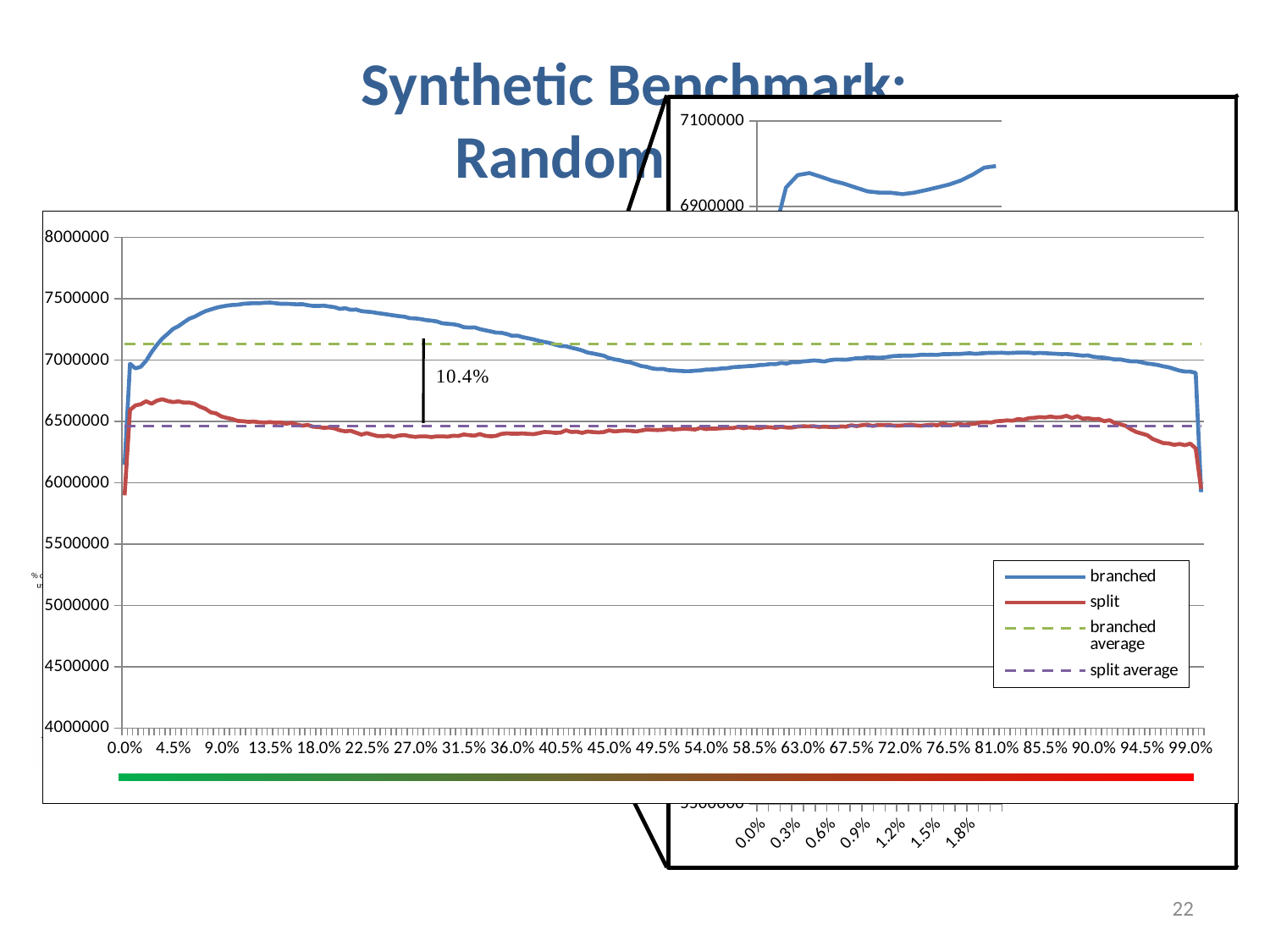
In the main chart, which series has the higher value at 13.5%, branched or split? branched In the main chart, is the value of the split series at 27.0% greater or less than 6500000? less In the main chart, is the value of the split series at 4.5% greater or less than 6500000? greater In the main chart, what percentage is printed in the annotation between the branched average and split average lines? 10.4% In the main chart, which series is plotted with the solid blue line? branched What kind of chart is the main chart on the slide? line chart In the main chart, is the value of the branched series at 13.5% greater or less than 7000000? greater In the main chart, does the branched series rise or fall between 13.5% and 49.5%? fall How many series does the legend of the main chart list? 4 In the main chart, which is higher, the branched average line or the split average line? branched average